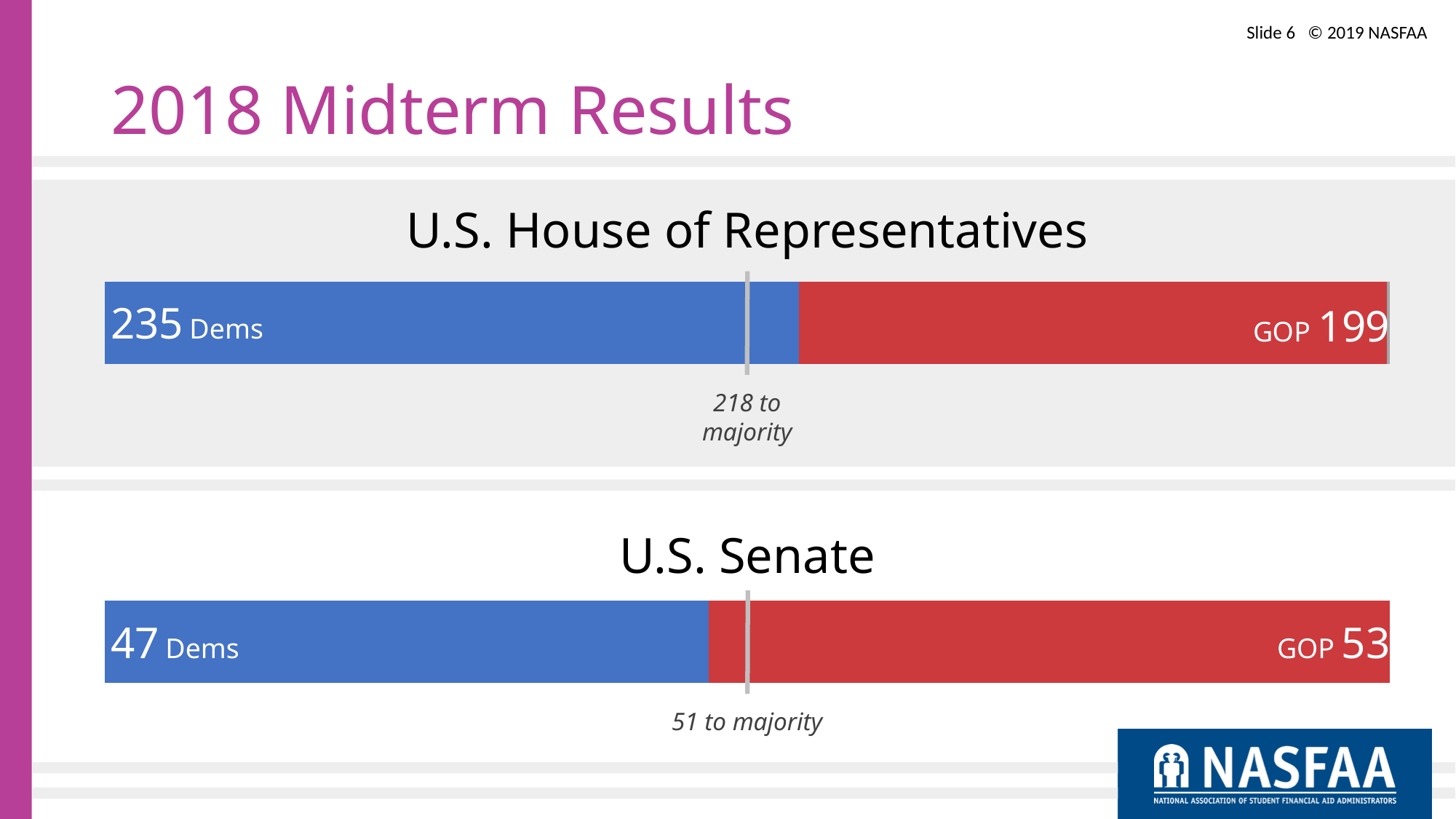
In the U.S. Senate chart, how many seats do the Dems hold? 47 In the U.S. Senate chart, which party has more seats? GOP What kind of chart is used for the U.S. Senate results? Bar chart In the U.S. House of Representatives chart, which party has more seats? Dems In the U.S. Senate chart, what is the total number of seats shown across both parties? 100 In the U.S. House of Representatives chart, how many seats do the Dems hold? 235 In the U.S. Senate chart, how many seats does the GOP hold? 53 In the U.S. House of Representatives chart, what is the total number of seats shown across both parties? 434 In the U.S. House of Representatives chart, what is the difference between the Dems' and GOP's seat counts? 36 In the U.S. Senate chart, what is the difference between the GOP's and Dems' seat counts? 6 In the U.S. House of Representatives chart, how many seats does the GOP hold? 199 In the U.S. House of Representatives chart, how many seats are needed for a majority according to the marker label? 218